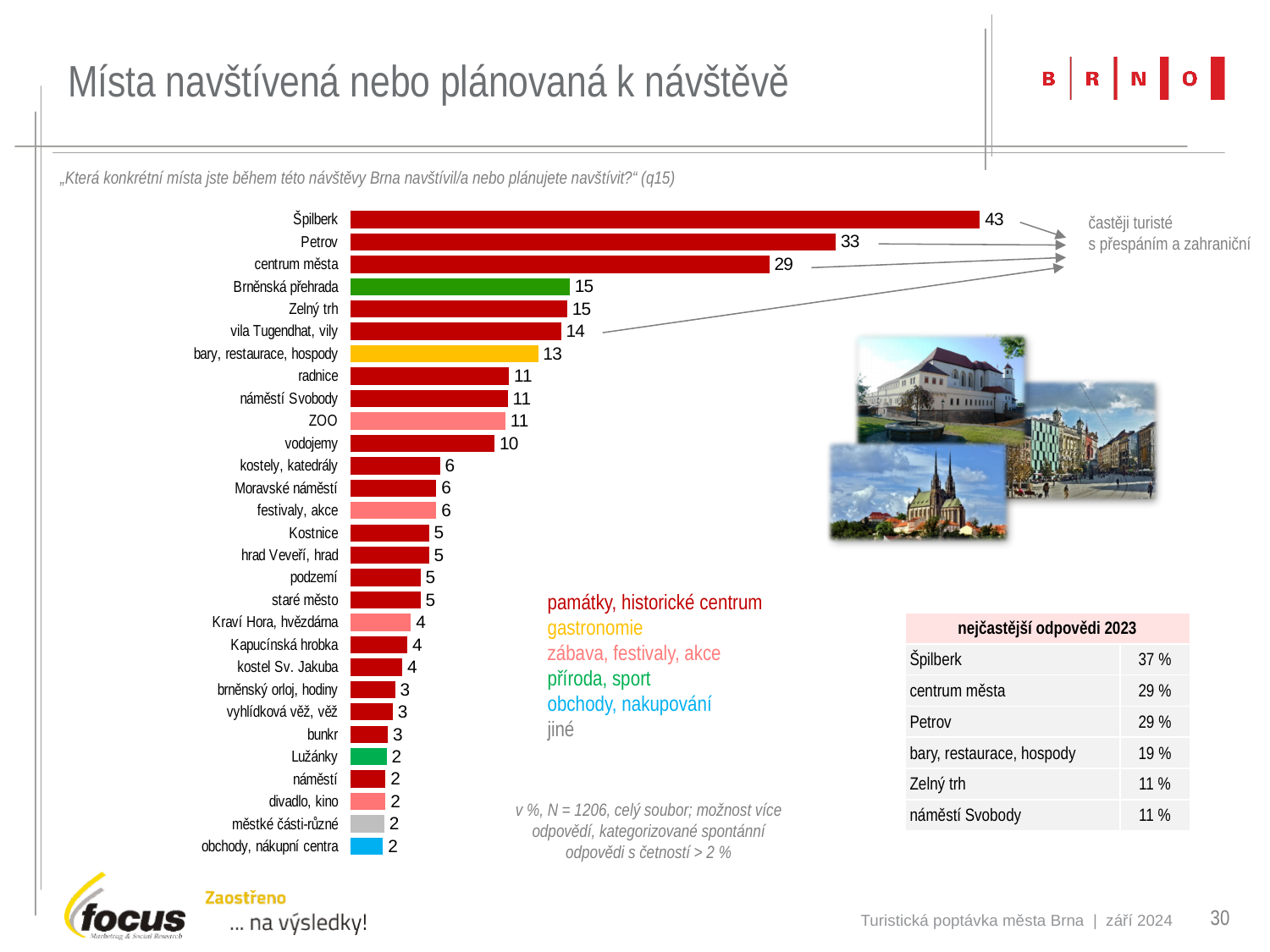
Which category has the highest value in the chart? Špilberk What value is shown for Petrov? 33 What is the difference between the values for Špilberk and Petrov? 10 Which has a larger value, vila Tugendhat, vily or radnice? vila Tugendhat, vily Which has a larger value, Kostnice or Kapucínská hrobka? Kostnice What colour is the bar for Brněnská přehrada? green What type of chart is shown on the slide? bar chart What value is shown for bary, restaurace, hospody? 13 What value is shown for Špilberk? 43 How many categories are plotted in the bar chart? 29 What value is shown for vodojemy? 10 What is the difference between the values for centrum města and Brněnská přehrada? 14